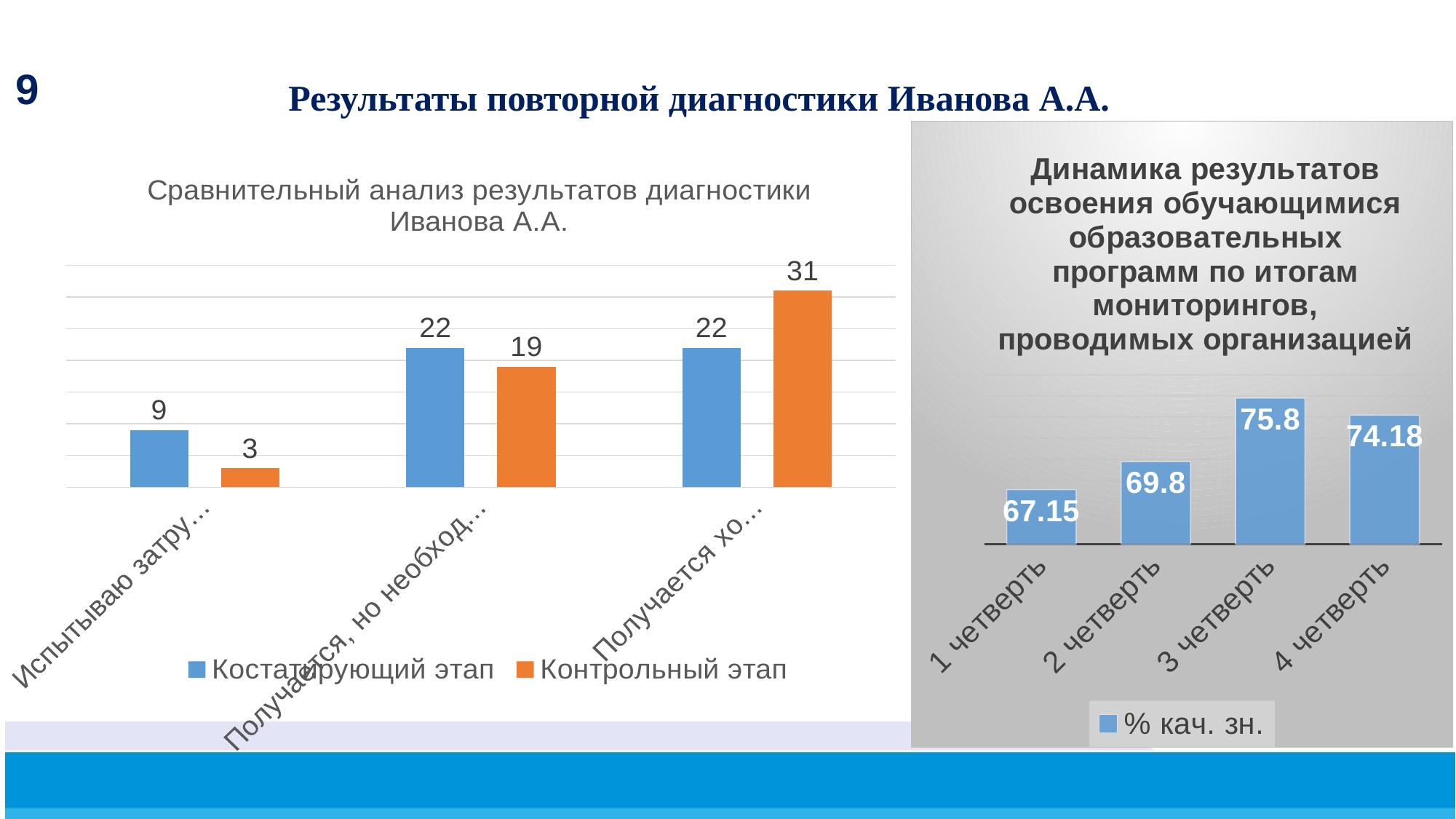
What type of chart is the right chart? Bar chart In the left chart, what is the value of Костатирующий этап for the first category? 9 In the left chart, how many categories are shown on the x axis? 3 In the right chart, what is the legend entry? % кач. зн. In the left chart, what is the value of Контрольный этап for the first category? 3 In the right chart (Динамика результатов освоения...), what is the value for 3 четверть? 75.8 In the left chart, what is the difference between Костатирующий этап and Контрольный этап for the second category? 3 In the left chart, which series has the larger value for the third category? Контрольный этап In the right chart, which quarter has the lowest value? 1 четверть In the left chart, how many series does the legend list? 2 In the left chart (Сравнительный анализ результатов диагностики Иванова А.А.), what is the value of Контрольный этап for the third category? 31 In the right chart, what is the difference between 2 четверть and 1 четверть? 2.65